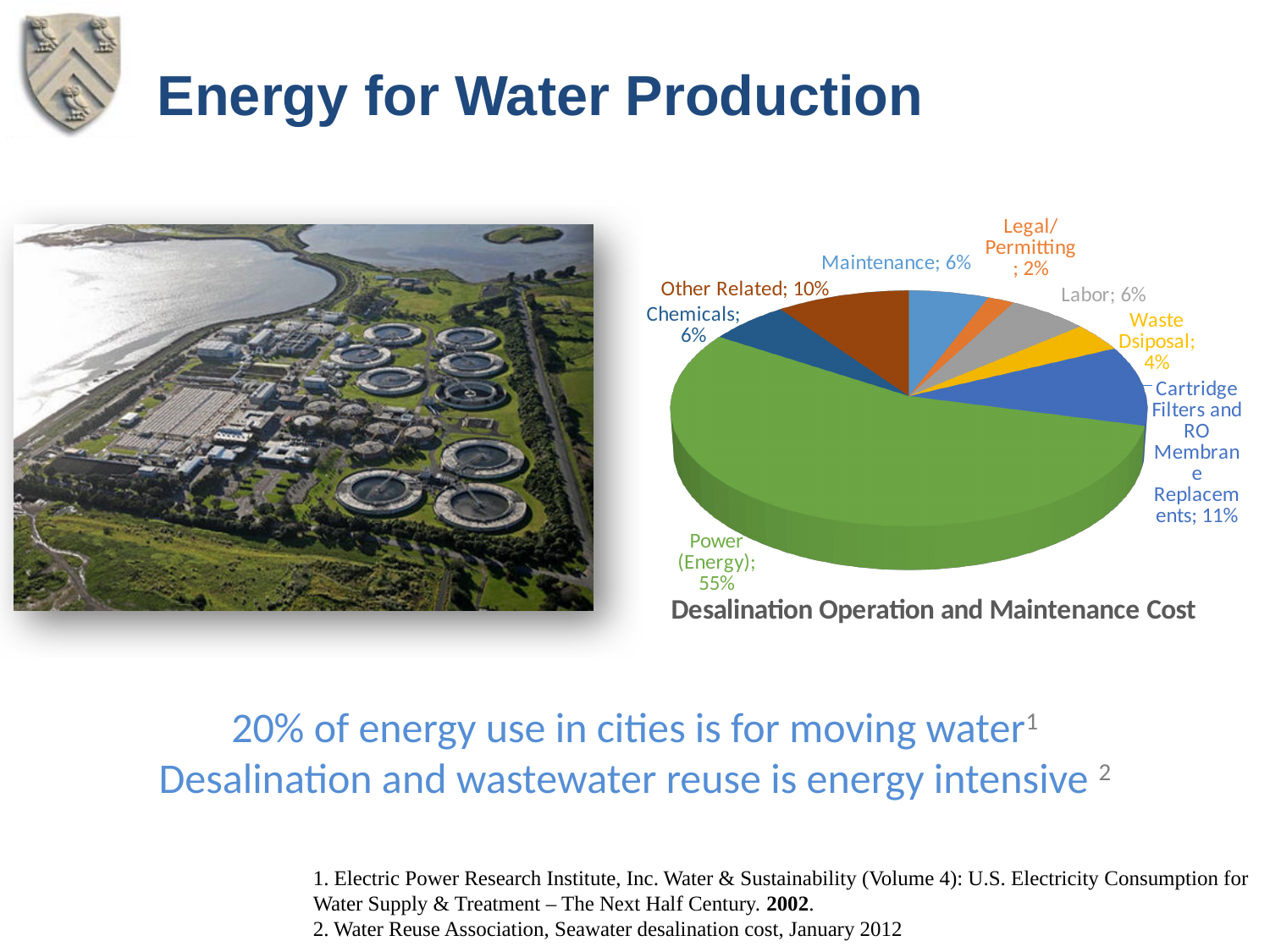
What is the title of the pie chart? Desalination Operation and Maintenance Cost How many slices does the pie chart have? 8 What share of the desalination operation and maintenance cost is Power (Energy)? 55% Which category has the largest share of the pie? Power (Energy) Which is larger, the share for Other Related or the share for Labor? Other Related What percentage of the cost is Waste Dsiposal? 4% What is the difference in percentage points between Power (Energy) and Cartridge Filters and RO Membrane Replacements? 44 What percentage of the cost is Other Related? 10% Which category has the smallest share of the pie? Legal/Permitting What percentage of the cost is Legal/Permitting? 2% What kind of chart is shown on the slide? pie chart What percentage of the cost is Cartridge Filters and RO Membrane Replacements? 11%